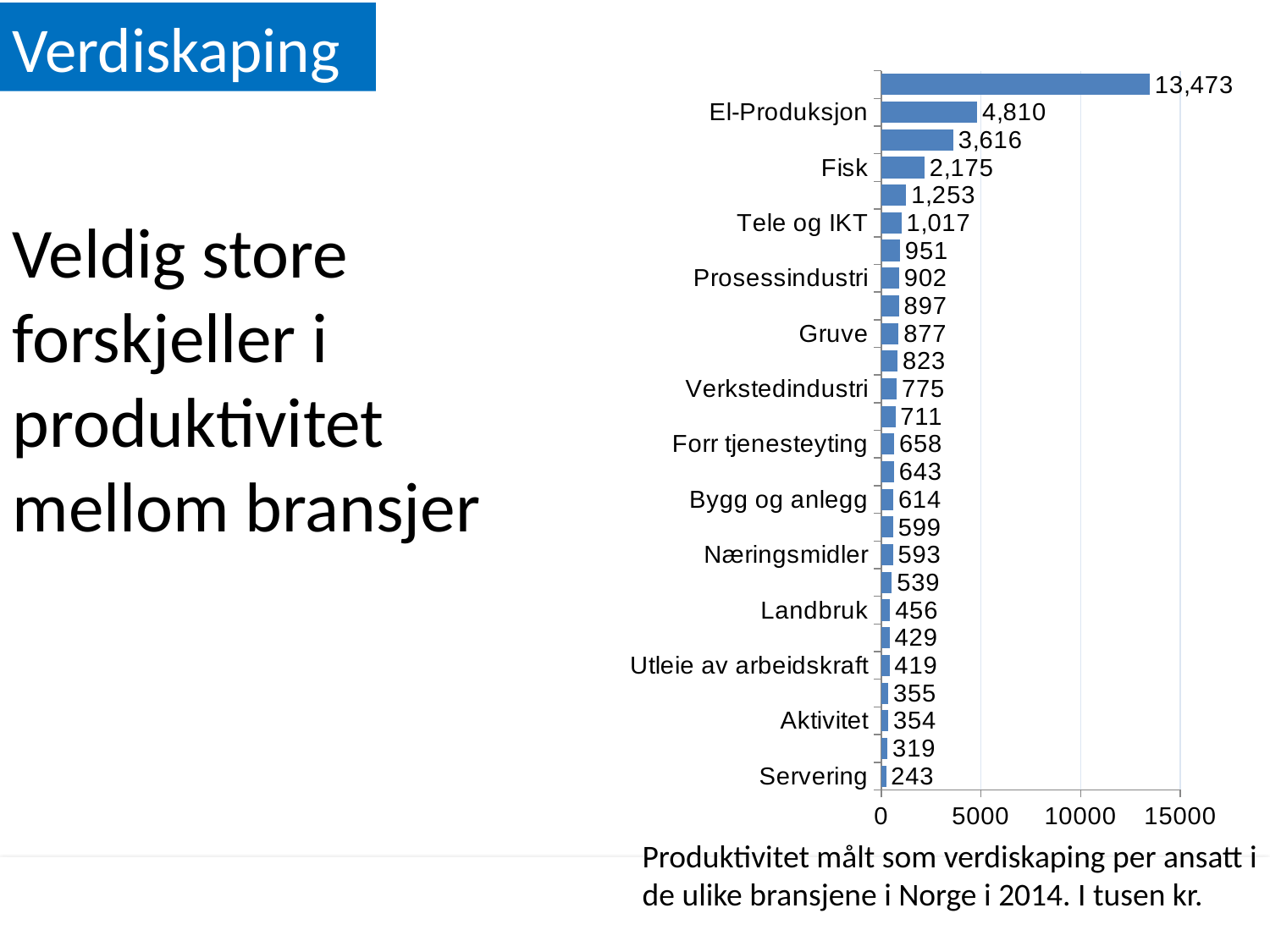
What is the value for El-Produksjon? 4,810 What kind of chart is shown on the slide? Bar chart Which labelled category has the lowest value? Servering What is the value for Utleie av arbeidskraft? 419 Which is larger, the value for Prosessindustri or the value for Gruve? Prosessindustri How many bars are plotted in the chart? 26 What is the difference between the values for Bygg og anlegg and Næringsmidler? 21 What is the value for Fisk? 2,175 Is the value for Tele og IKT greater or less than 5000? less What is the value for Landbruk? 456 What is the value for Servering? 243 What is the difference between the values for El-Produksjon and Fisk? 2,635